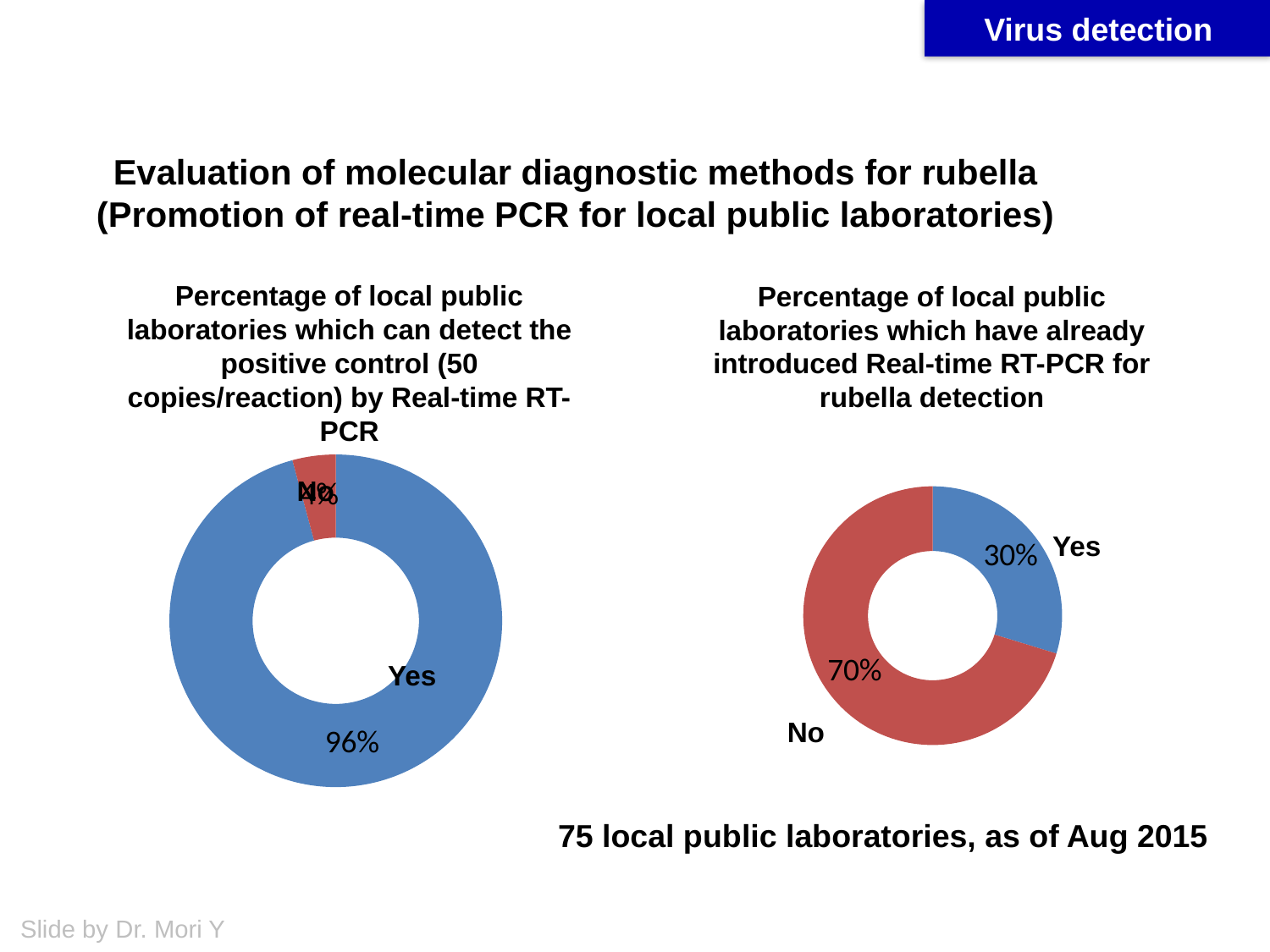
How many categories does the right chart (laboratories which have already introduced Real-time RT-PCR) show? 2 In the left chart (laboratories which can detect the positive control by Real-time RT-PCR), what percentage of laboratories answered Yes? 96% How many categories does the left chart (laboratories which can detect the positive control) show? 2 How many charts are shown on the slide? 2 In the right chart (laboratories which have already introduced Real-time RT-PCR for rubella detection), what percentage answered No? 70% What kind of chart is used on this slide? Doughnut (pie) chart Is the Yes share larger in the left chart (can detect the positive control) or in the right chart (have already introduced Real-time RT-PCR)? Left chart In the right chart (laboratories which have already introduced Real-time RT-PCR), what is the difference in percentage points between No and Yes? 40 In the right chart (laboratories which have already introduced Real-time RT-PCR), what colour is the No slice? Red In the right chart (laboratories which have already introduced Real-time RT-PCR), which category has the larger share? No In the right chart (laboratories which have already introduced Real-time RT-PCR for rubella detection), what percentage answered Yes? 30% In the left chart (laboratories which can detect the positive control), which category has the smaller share? No